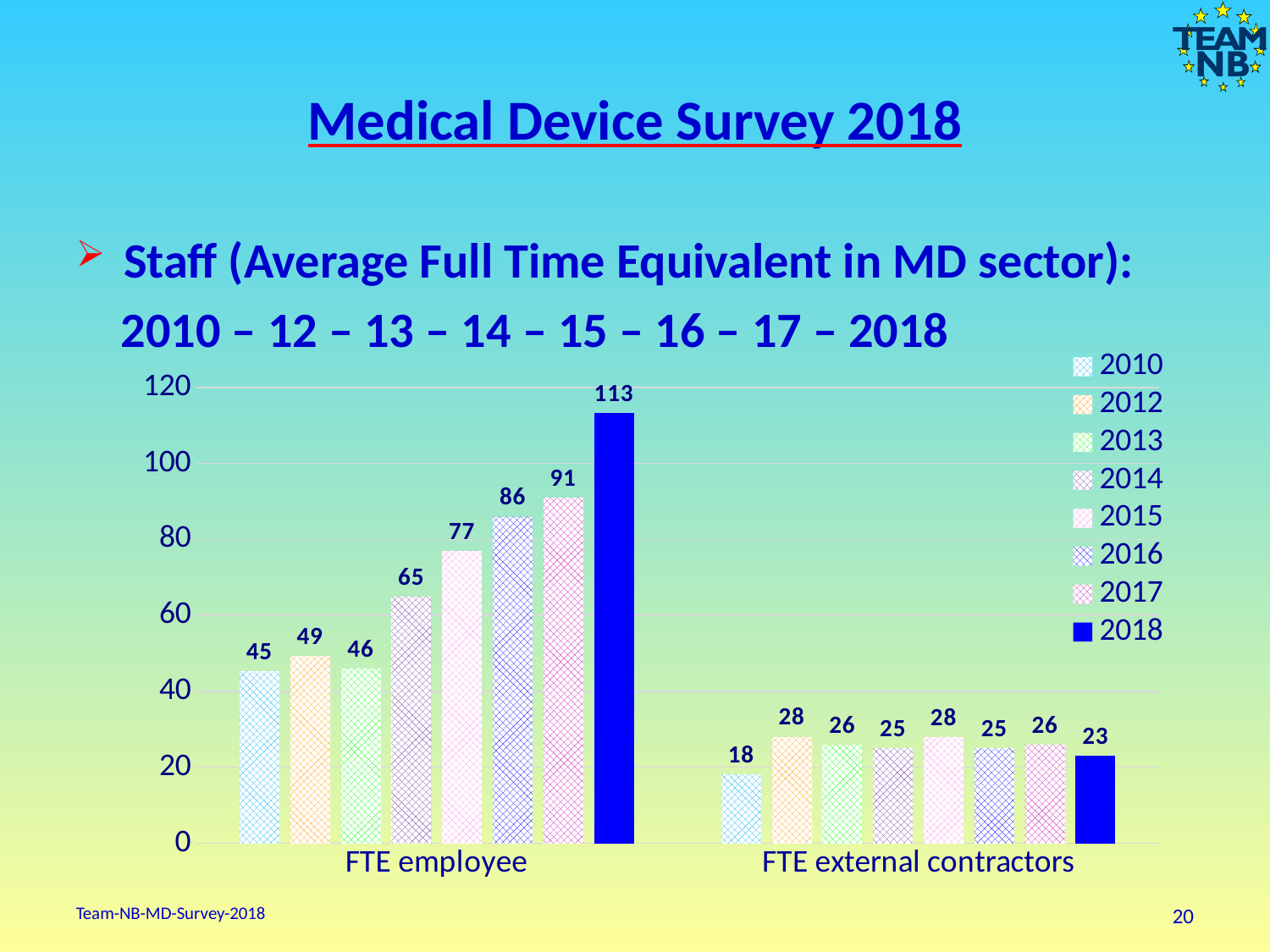
Which year has the highest value in the FTE employee category? 2018 Is the 2017 value for FTE employee greater or less than 80? greater What is the value for 2010 in the FTE external contractors category? 18 What is the difference between the 2018 and 2010 values in the FTE employee category? 68 What is the value for 2015 in the FTE employee category? 77 How many series does the legend list? 8 How many categories are shown on the x axis? 2 Which is larger: the 2012 value or the 2013 value for FTE employee? 2012 Which year has the lowest value in the FTE external contractors category? 2010 What is the value for 2018 in the FTE employee category? 113 What kind of chart is shown on the slide? bar chart Which year is shown with a solid blue bar in the legend? 2018